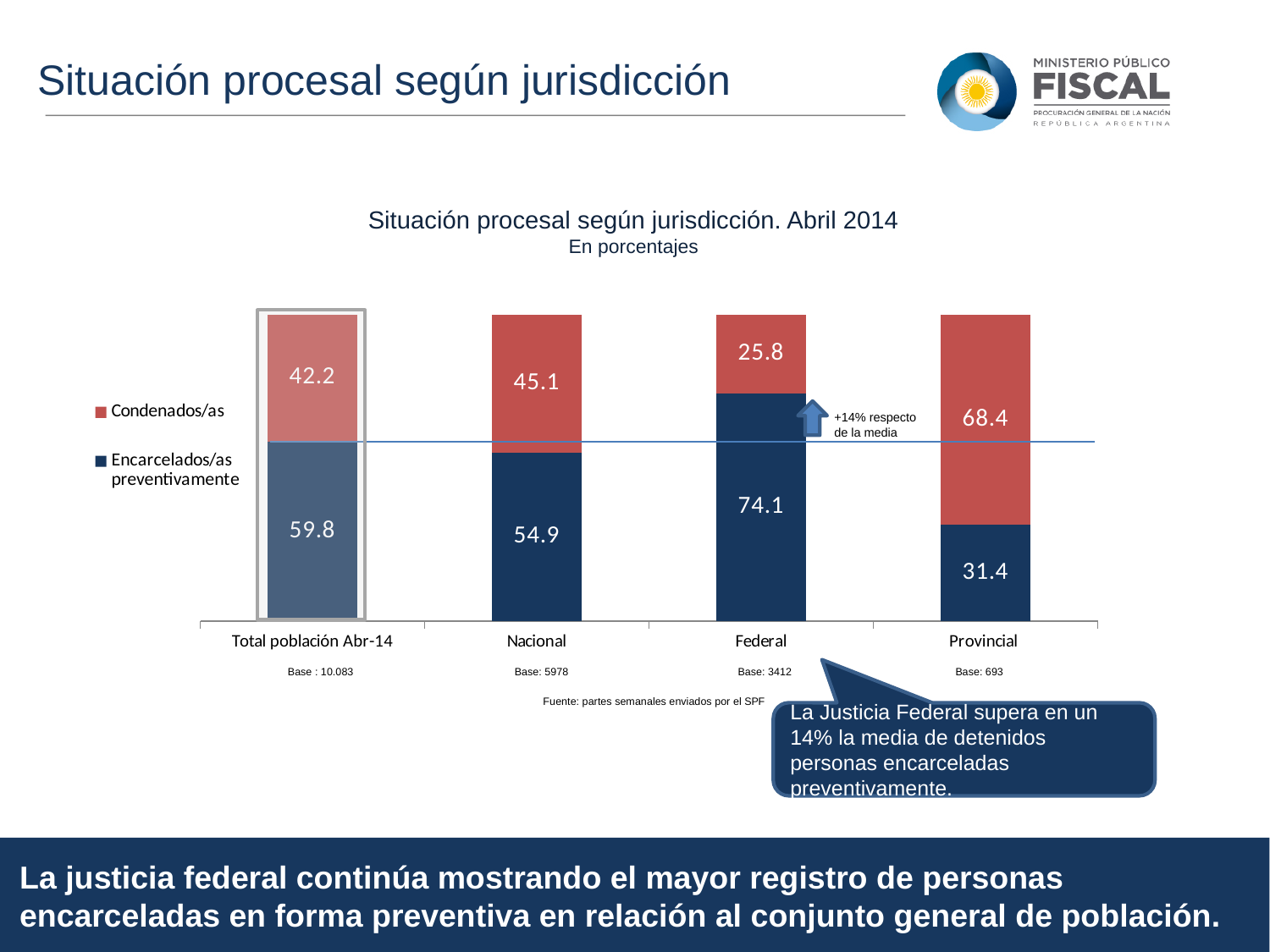
How many series does the legend list? 2 Which is larger: the Condenados/as value for Nacional or for Provincial? Provincial What kind of chart is shown on the slide? Stacked bar chart Which category has the lowest value for Condenados/as? Federal How many categories are shown on the x axis? 4 What is the value for Encarcelados/as preventivamente in the Nacional category? 54.9 What is the value for Encarcelados/as preventivamente in the Federal category? 74.1 What is the total of the stacked bar for Nacional? 100 What is the difference between the Encarcelados/as preventivamente value for Federal and for Total población Abr-14? 14.3 What is the value for Condenados/as in the Provincial category? 68.4 Which category has the highest value for Encarcelados/as preventivamente? Federal What is the value for Condenados/as in the Total población Abr-14 category? 42.2